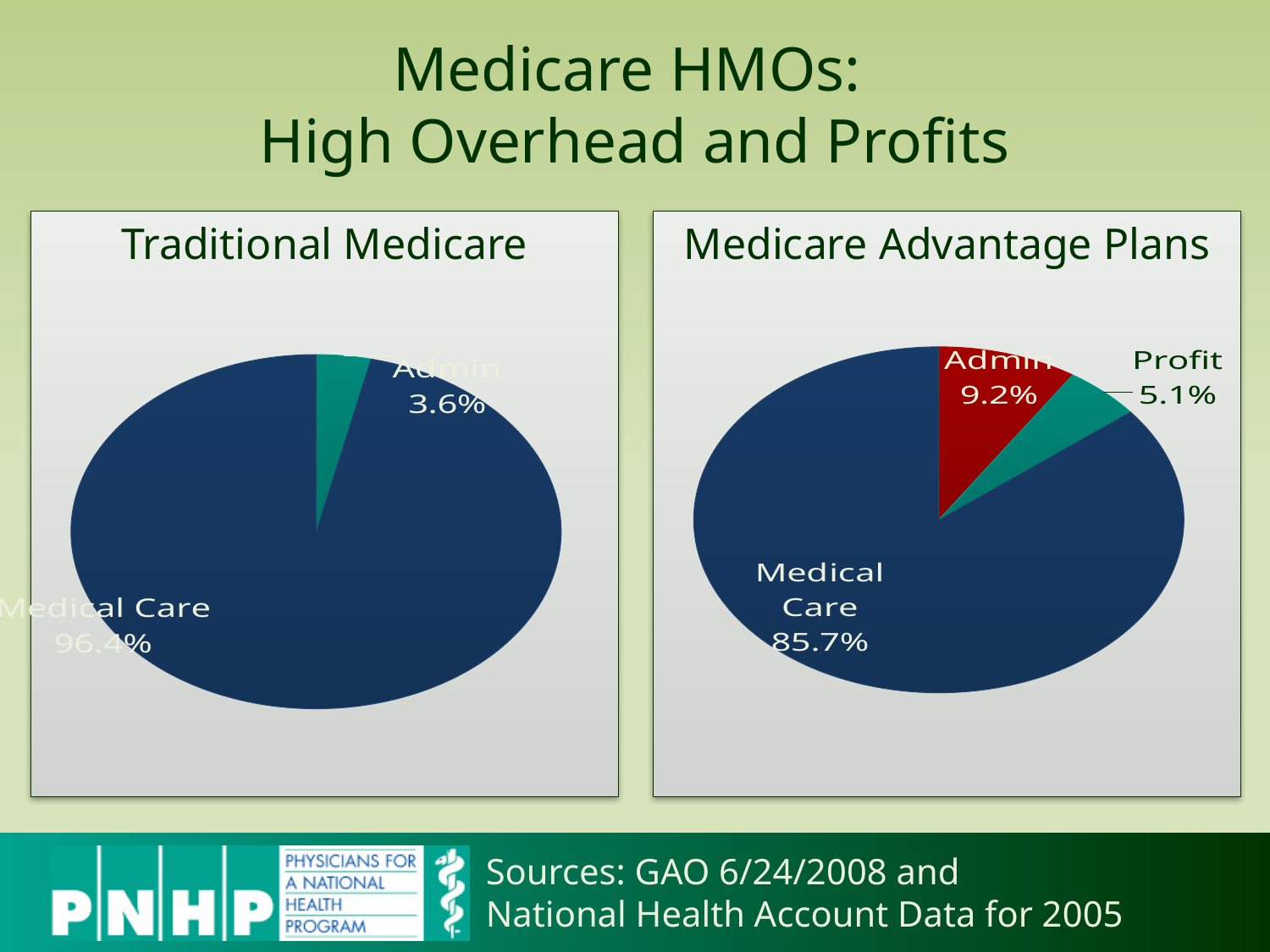
In the Medicare Advantage Plans chart, what share is Profit? 5.1% What type of chart is used on this slide? Pie chart In the Traditional Medicare chart, what share is Medical Care? 96.4% What is the difference between the Admin share in the Medicare Advantage Plans chart and the Admin share in the Traditional Medicare chart? 5.6% In the Traditional Medicare chart, how many slices does the pie have? 2 In the Traditional Medicare chart, what share is Admin? 3.6% In the Medicare Advantage Plans chart, which slice is the largest? Medical Care In the Medicare Advantage Plans chart, what share is Medical Care? 85.7% In the Medicare Advantage Plans chart, what share is Admin? 9.2% Which is larger: the Admin share in the Medicare Advantage Plans chart or the Profit share in the same chart? Admin In the Medicare Advantage Plans chart, which slice is the smallest? Profit In the Medicare Advantage Plans chart, how many slices does the pie have? 3